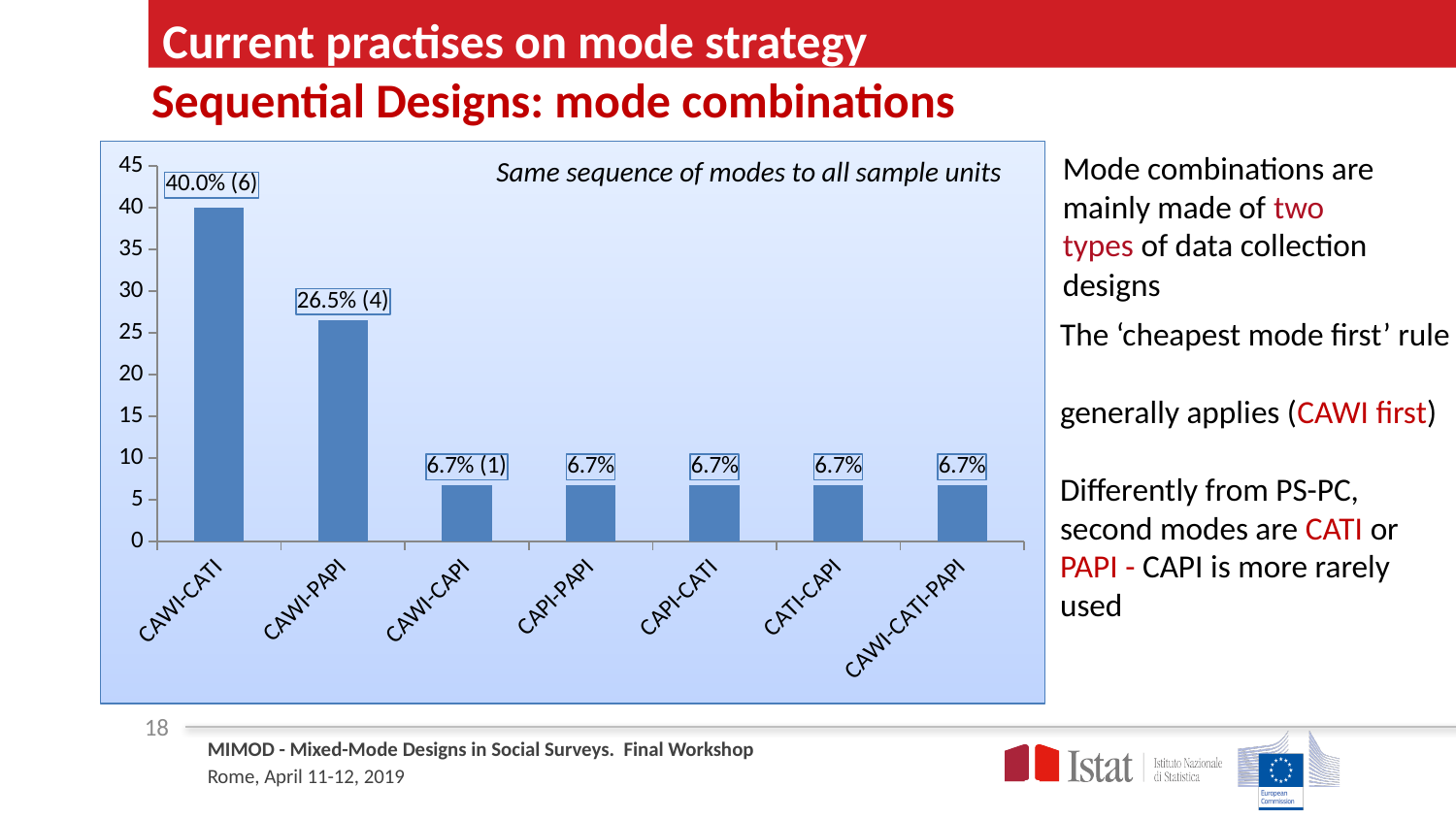
Do the values rise or fall moving from left to right along the x axis? fall What percentage is shown for CATI-CAPI? 6.7% What is the data label shown for CAWI-CAPI? 6.7% (1) What is the data label shown for CAWI-CATI? 40.0% (6) What text is written in italics at the top of the chart area? Same sequence of modes to all sample units What is the difference in percentage between CAWI-CATI and CAWI-PAPI? 13.5% How many mode combinations (categories) are plotted on the chart? 7 Which mode combination has the highest value? CAWI-CATI Is the value for CAWI-PAPI greater or less than 25? greater What is the data label shown for CAWI-PAPI? 26.5% (4) What kind of chart is shown on the slide? bar chart Which is larger, the value for CAWI-PAPI or the value for CAPI-PAPI? CAWI-PAPI